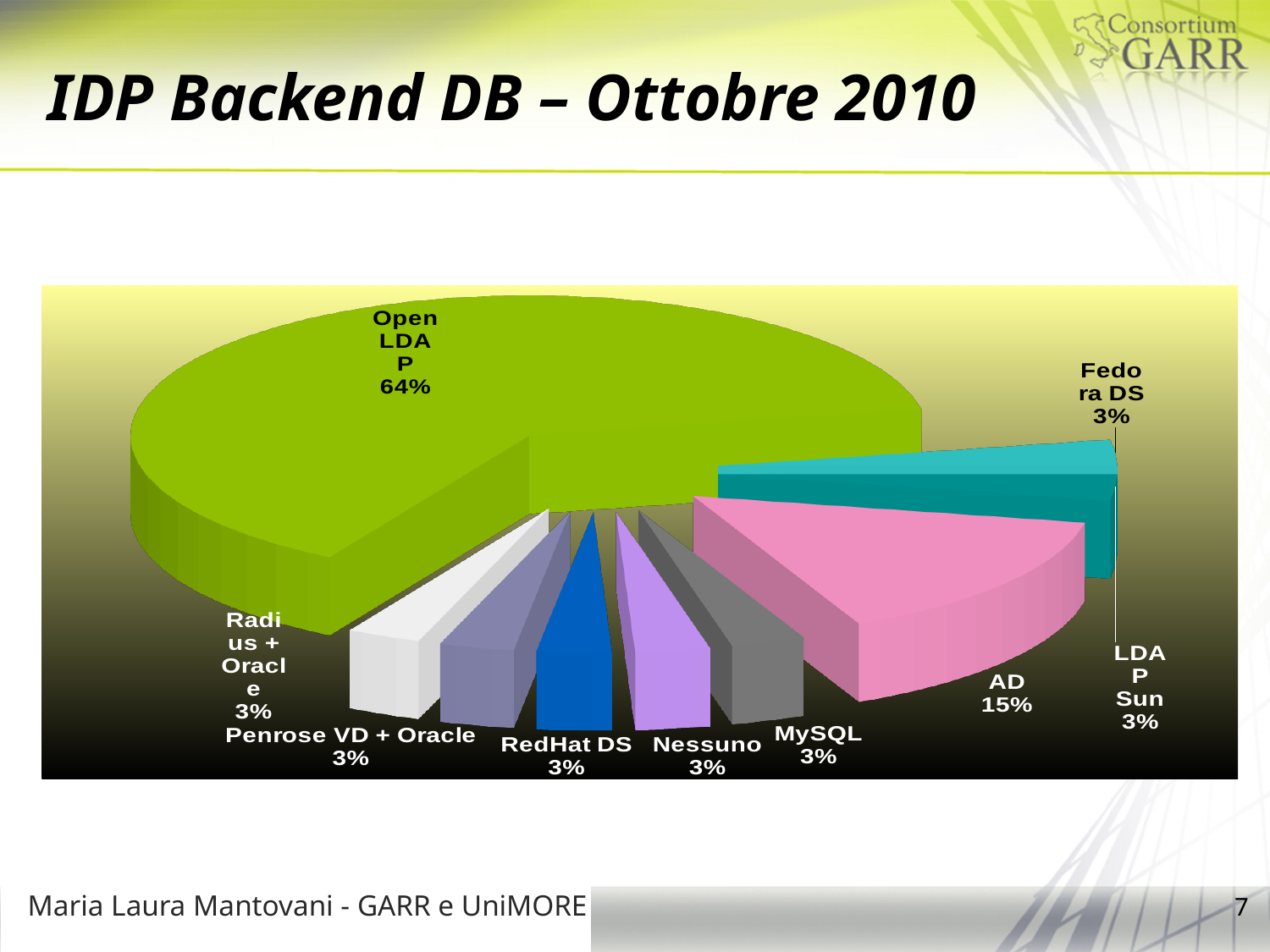
What percentage is shown for AD? 15% Which category has the second-largest slice of the pie? AD What percentage is shown for Fedora DS? 3% How many slices does the pie chart have? 9 What percentage is shown for MySQL? 3% How many slices are labelled 3%? 7 What share of the pie does Open LDAP hold? 64% What is the difference in percentage points between Open LDAP and AD? 49% Which is larger, the share for AD or the share for Nessuno? AD What kind of chart is shown on the slide? Pie chart Which category has the largest slice of the pie? Open LDAP What is the title of the slide containing the chart? IDP Backend DB – Ottobre 2010